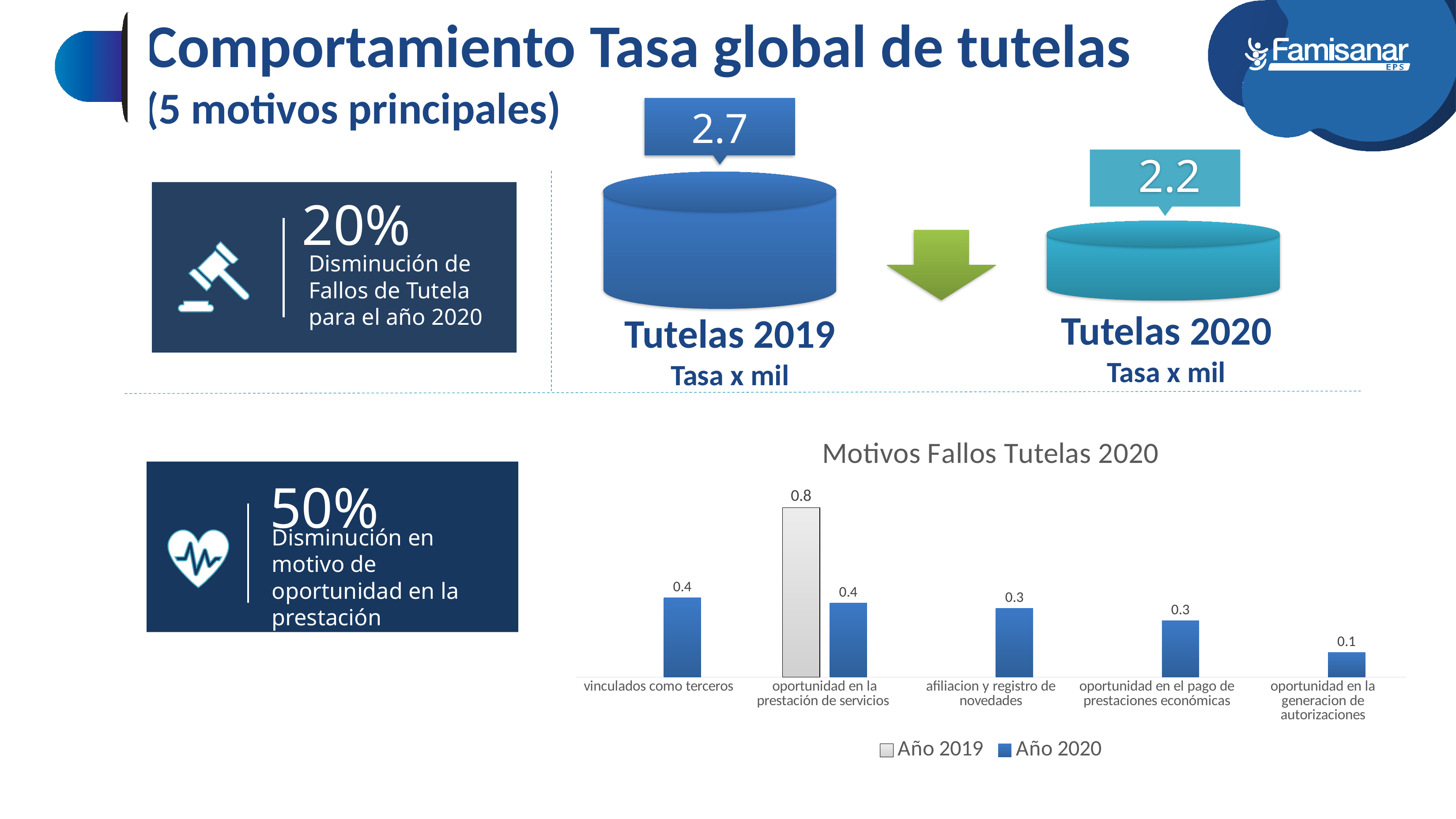
In the "Motivos Fallos Tutelas 2020" chart, which category has the lowest Año 2020 value? oportunidad en la generacion de autorizaciones In the "Motivos Fallos Tutelas 2020" chart, what is the Año 2020 value for "oportunidad en el pago de prestaciones económicas"? 0.3 In the "Motivos Fallos Tutelas 2020" chart, what is the Año 2019 value for "oportunidad en la prestación de servicios"? 0.8 In the "Motivos Fallos Tutelas 2020" chart, what is the difference between the Año 2019 and Año 2020 values for "oportunidad en la prestación de servicios"? 0.4 In the "Motivos Fallos Tutelas 2020" chart, what is the Año 2020 value for "oportunidad en la generacion de autorizaciones"? 0.1 How many categories are shown on the x axis of the "Motivos Fallos Tutelas 2020" chart? 5 In the "Motivos Fallos Tutelas 2020" chart, what is the Año 2020 value for "oportunidad en la prestación de servicios"? 0.4 What type of chart is "Motivos Fallos Tutelas 2020"? bar chart In the "Motivos Fallos Tutelas 2020" chart, what is the Año 2020 value for "vinculados como terceros"? 0.4 What are the two legend entries of the "Motivos Fallos Tutelas 2020" chart? Año 2019 and Año 2020 How many series does the legend of the "Motivos Fallos Tutelas 2020" chart list? 2 In the "Motivos Fallos Tutelas 2020" chart, which is larger: the Año 2020 value for "afiliacion y registro de novedades" or for "oportunidad en la generacion de autorizaciones"? afiliacion y registro de novedades